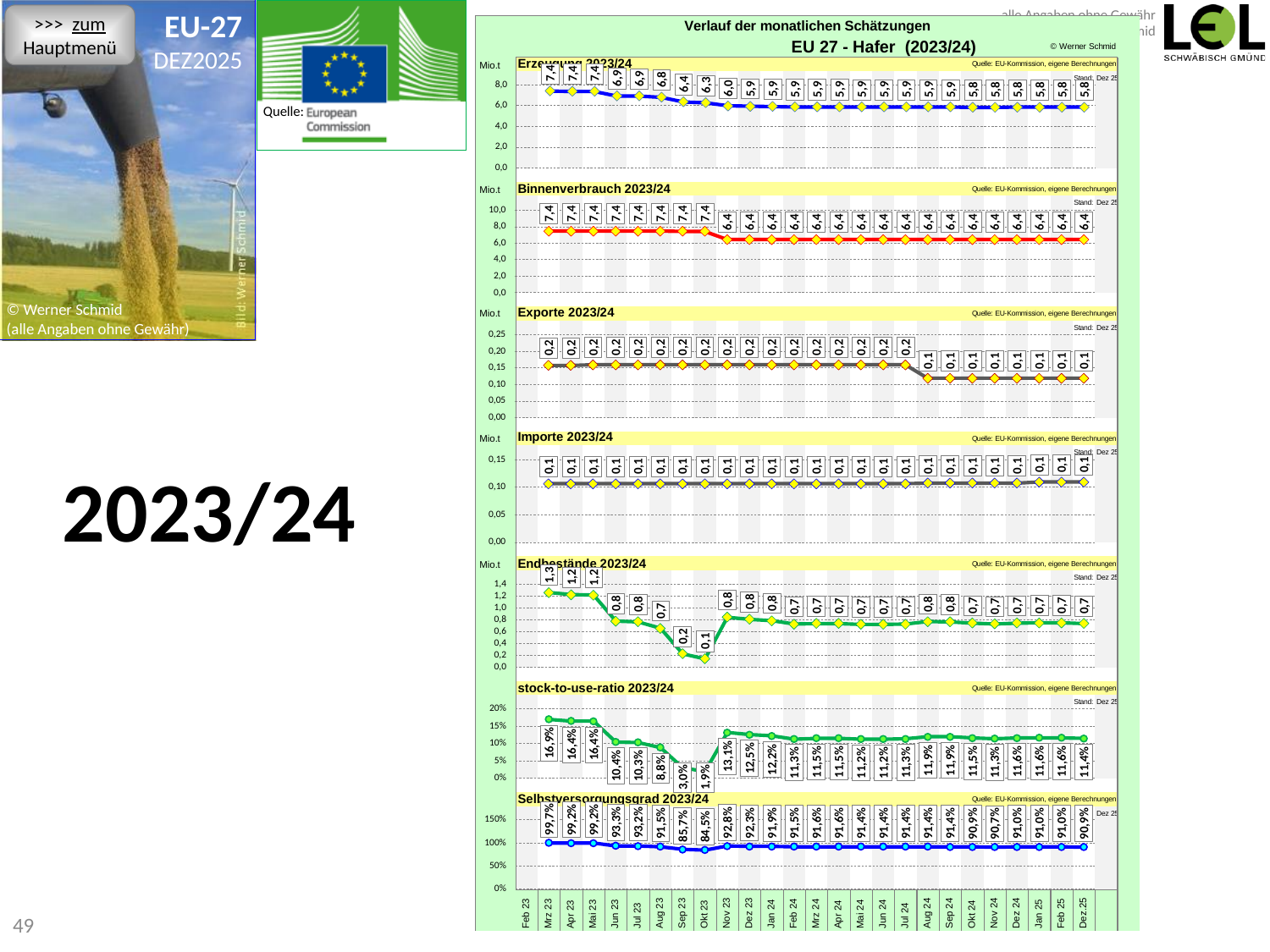
What is the main title printed above the panel of charts? Verlauf der monatlichen Schätzungen EU 27 - Hafer (2023/24) In the 'stock-to-use-ratio 2023/24' chart, what is the lowest value shown? 1,9% In the 'Endbestände 2023/24' chart, what is the highest value shown? 1,3 In the 'Selbstversorgungsgrad 2023/24' chart, is the last value (Dez 25) greater or less than 100%? less In the 'Endbestände 2023/24' chart, what is the lowest value shown? 0,1 In the 'Erzeugung 2023/24' chart, what is the difference between the first value (7,4) and the last value (5,8)? 1,6 In the 'Erzeugung 2023/24' chart, do the values rise or fall over time along the x axis? fall What kind of chart is used in the 'Erzeugung 2023/24' panel? line chart In the 'Erzeugung 2023/24' chart, what is the value of the last data point (Dez 25)? 5,8 In the 'Binnenverbrauch 2023/24' chart, what is the value of the last data point (Dez 25)? 6,4 In the 'Erzeugung 2023/24' chart, what is the value of the first data point? 7,4 Comparing the last data points, which is larger: Binnenverbrauch 2023/24 or Erzeugung 2023/24? Binnenverbrauch 2023/24